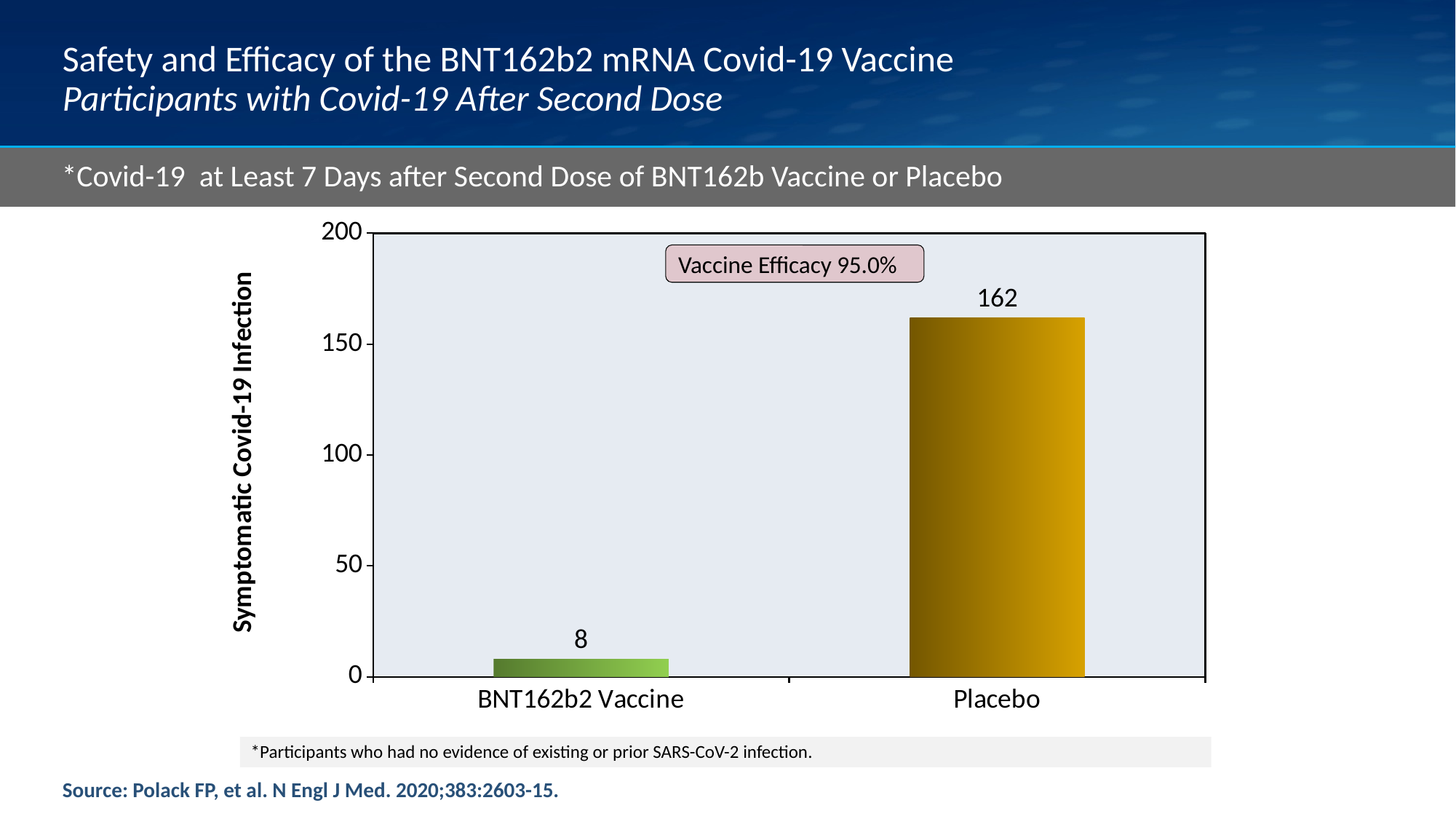
Is the value for BNT162b2 Vaccine greater or less than 50? less What is the difference between the Placebo value and the BNT162b2 Vaccine value? 154 What kind of chart is shown? bar chart What is the y-axis label of the chart? Symptomatic Covid-19 Infection What is the value for Placebo? 162 What is the value for BNT162b2 Vaccine? 8 What vaccine efficacy is stated in the box on the chart? 95.0% Is the value for Placebo greater or less than 150? greater How many categories are shown on the x axis? 2 Which is larger, the value for Placebo or the value for BNT162b2 Vaccine? Placebo Which category has the lowest value? BNT162b2 Vaccine Which category has the highest value? Placebo